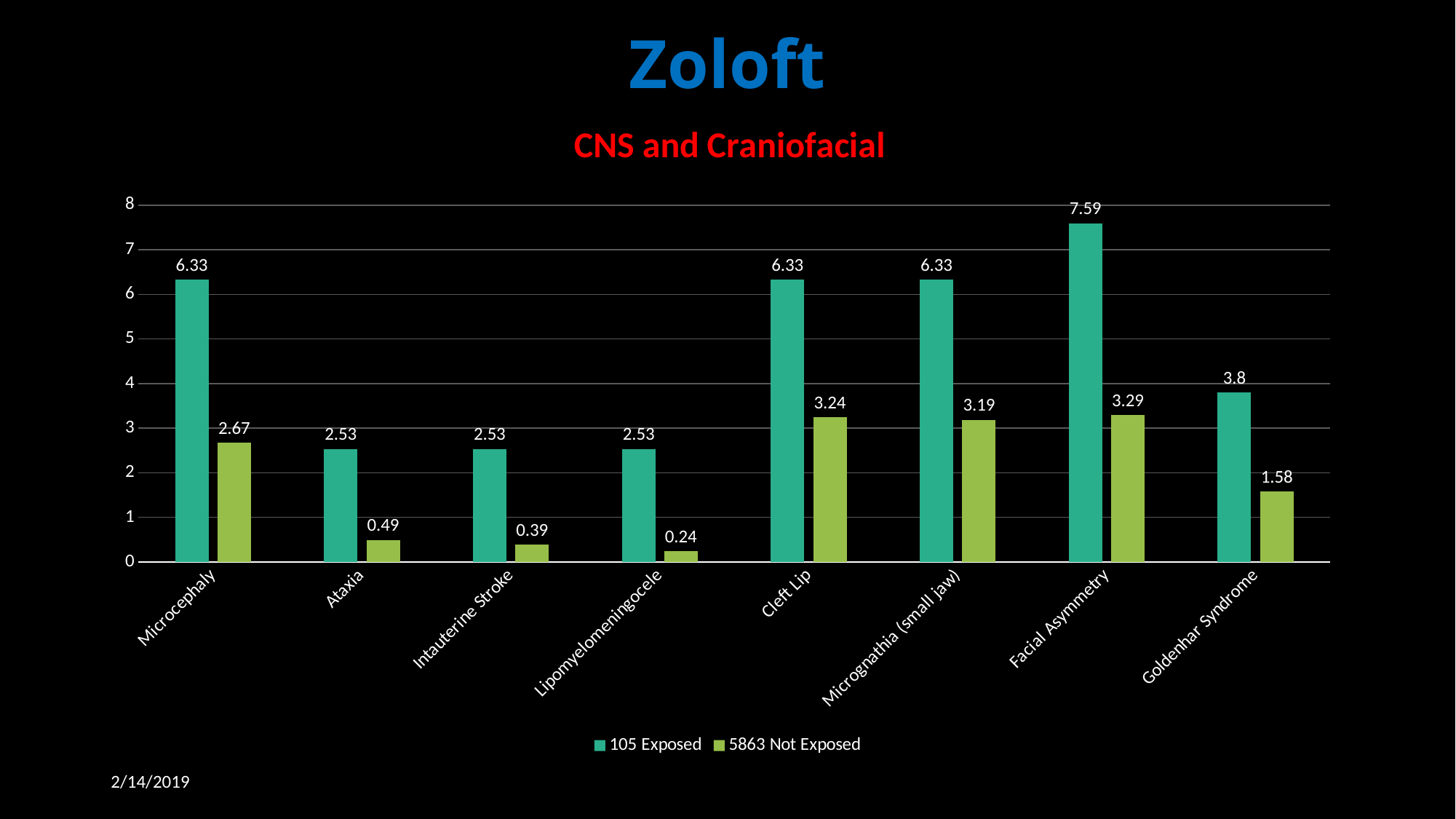
Which is larger for Micrognathia (small jaw): the 105 Exposed value or the 5863 Not Exposed value? 105 Exposed Which category has the highest value for 105 Exposed? Facial Asymmetry Is the 105 Exposed value for Goldenhar Syndrome greater or less than 3? greater Which category has the lowest value for 5863 Not Exposed? Lipomyelomeningocele What is the value for 105 Exposed for Microcephaly? 6.33 What is the value for 5863 Not Exposed for Goldenhar Syndrome? 1.58 How many series does the legend list? 2 How many categories are shown on the x axis? 8 What is the value for 5863 Not Exposed for Ataxia? 0.49 What kind of chart is shown on the slide? Bar chart What is the difference between the 105 Exposed and 5863 Not Exposed values for Cleft Lip? 3.09 What is the chart's title? CNS and Craniofacial